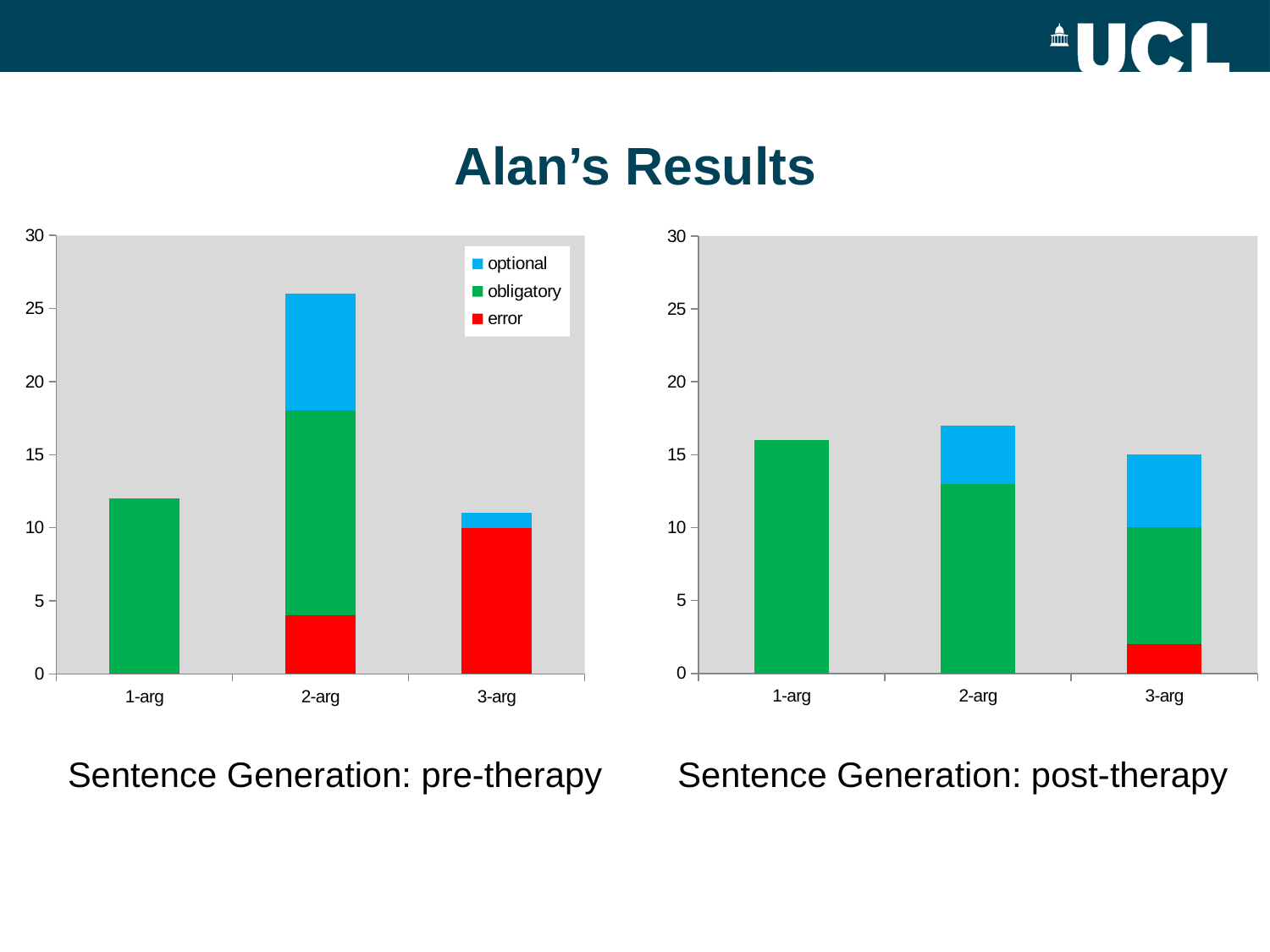
In the post-therapy chart, is the total for 3-arg greater or less than 20? less What kind of chart is the pre-therapy chart on the left? bar chart In the pre-therapy chart, which colour represents the error series? red How many categories are shown on the x axis of the post-therapy chart on the right? 3 What are the three legend entries in the pre-therapy chart? optional, obligatory, error In the pre-therapy chart, which category has the tallest stacked bar? 2-arg In the pre-therapy chart, is the value for 1-arg greater or less than 10? greater In the pre-therapy chart, is the total for 2-arg greater or less than 25? greater In the pre-therapy chart, which stacked bar is taller, 2-arg or 3-arg? 2-arg How many series does the legend of the pre-therapy chart list? 3